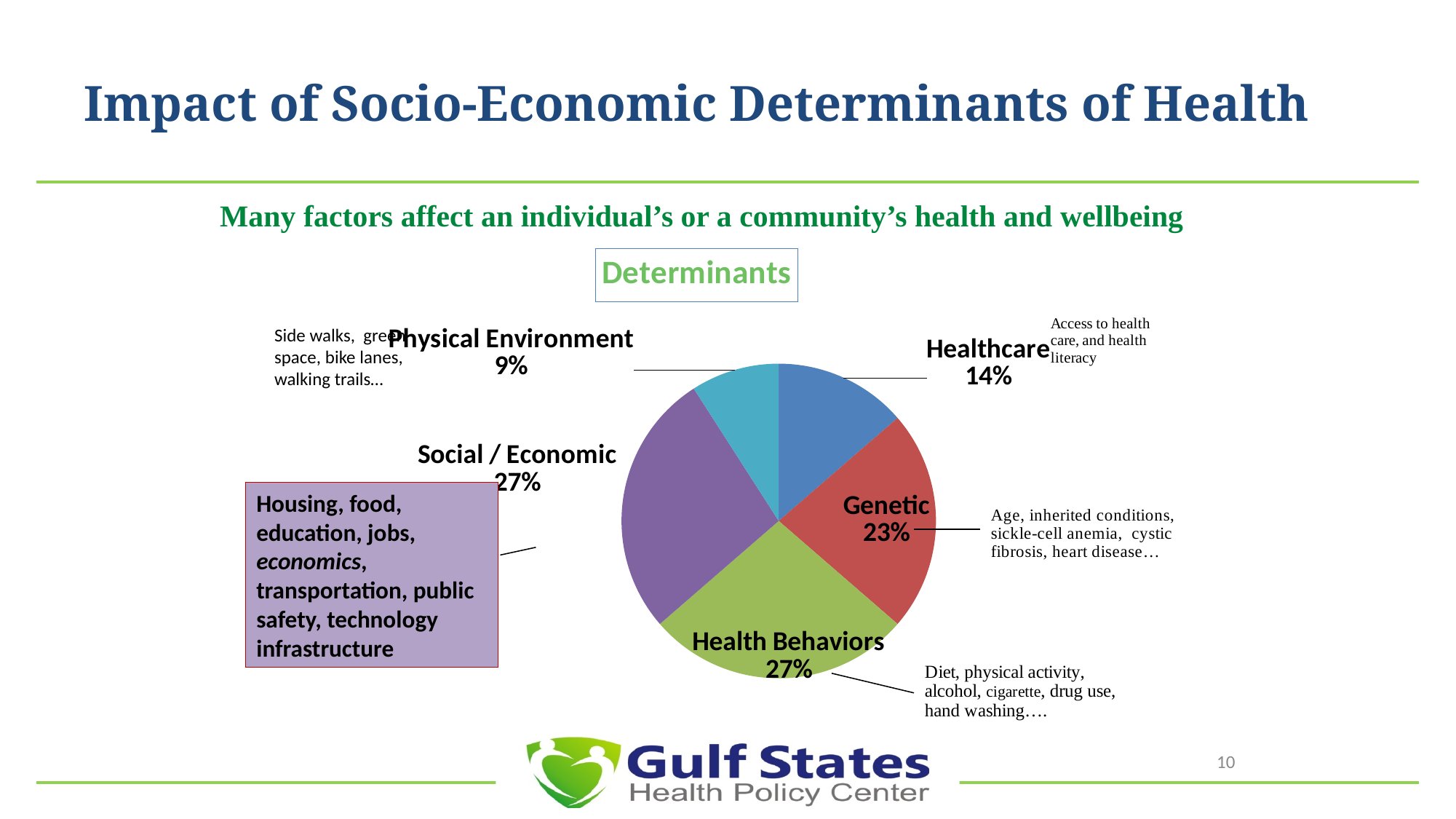
What kind of chart is shown on the slide? pie chart What is the difference in percentage points between Health Behaviors and Physical Environment? 18 What share of the pie does Healthcare account for? 14% What share of the pie does Health Behaviors account for? 27% Which slice of the pie is the smallest? Physical Environment What share of the pie does Genetic account for? 23% What is the title shown above the pie chart? Determinants Which is larger, the Genetic slice or the Healthcare slice? Genetic How many slices does the pie chart have? 5 What is the difference in percentage points between Genetic and Healthcare? 9